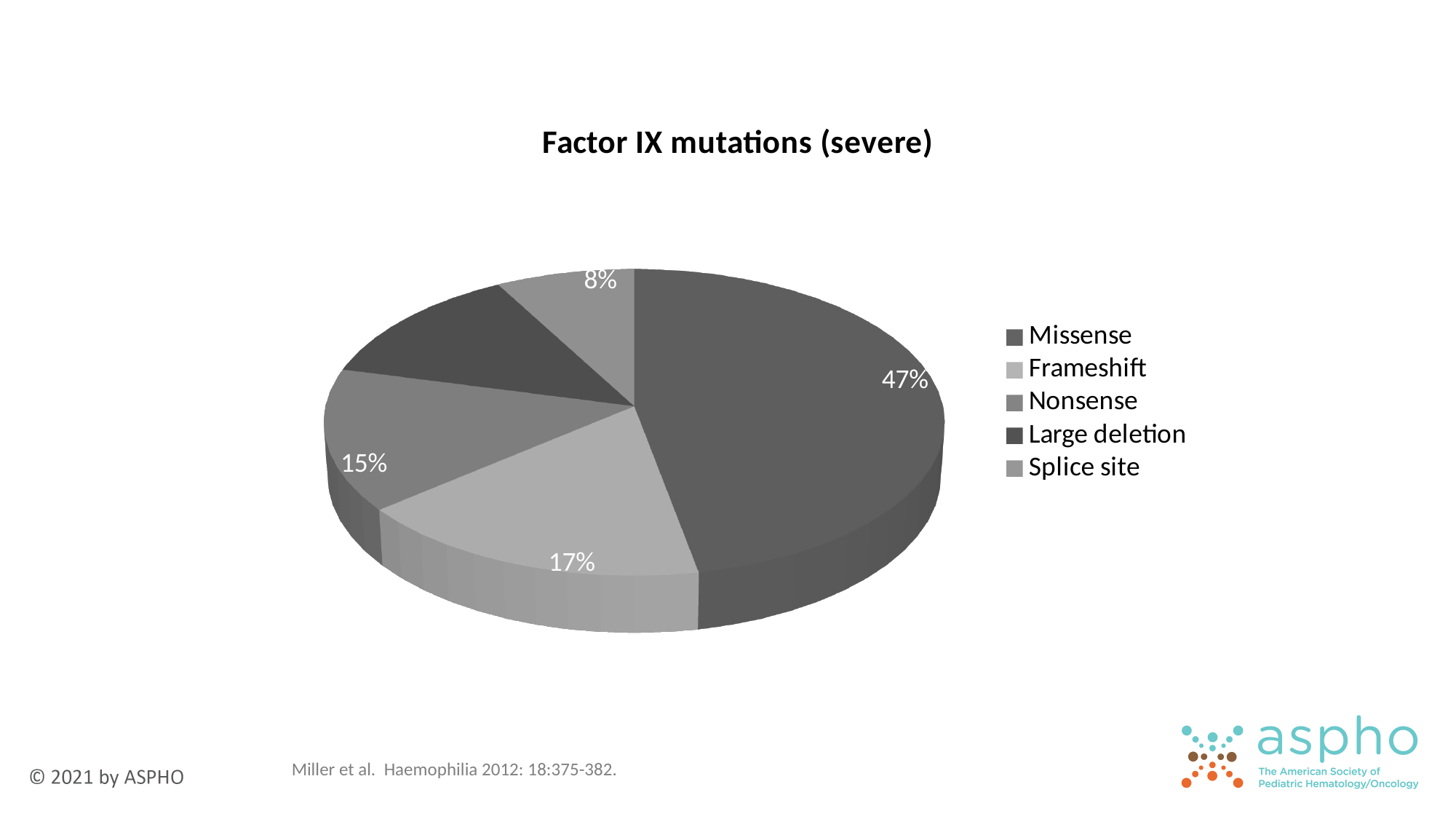
What percentage of severe Factor IX mutations are Missense? 47% How many mutation categories are listed in the legend? 5 Which has a larger share, Frameshift or Nonsense? Frameshift What share of the pie is labelled for Frameshift mutations? 17% Which mutation type makes up the largest slice of the pie? Missense What percentage is shown for Splice site mutations? 8% How many percentage points larger is the Missense share than the Frameshift share? 30% What is the title of the chart? Factor IX mutations (severe) What type of chart is shown on the slide? Pie chart What is the difference between the Frameshift and Nonsense percentages? 2% What percentage is shown for Nonsense mutations? 15% Which mutation type makes up the smallest slice of the pie? Splice site